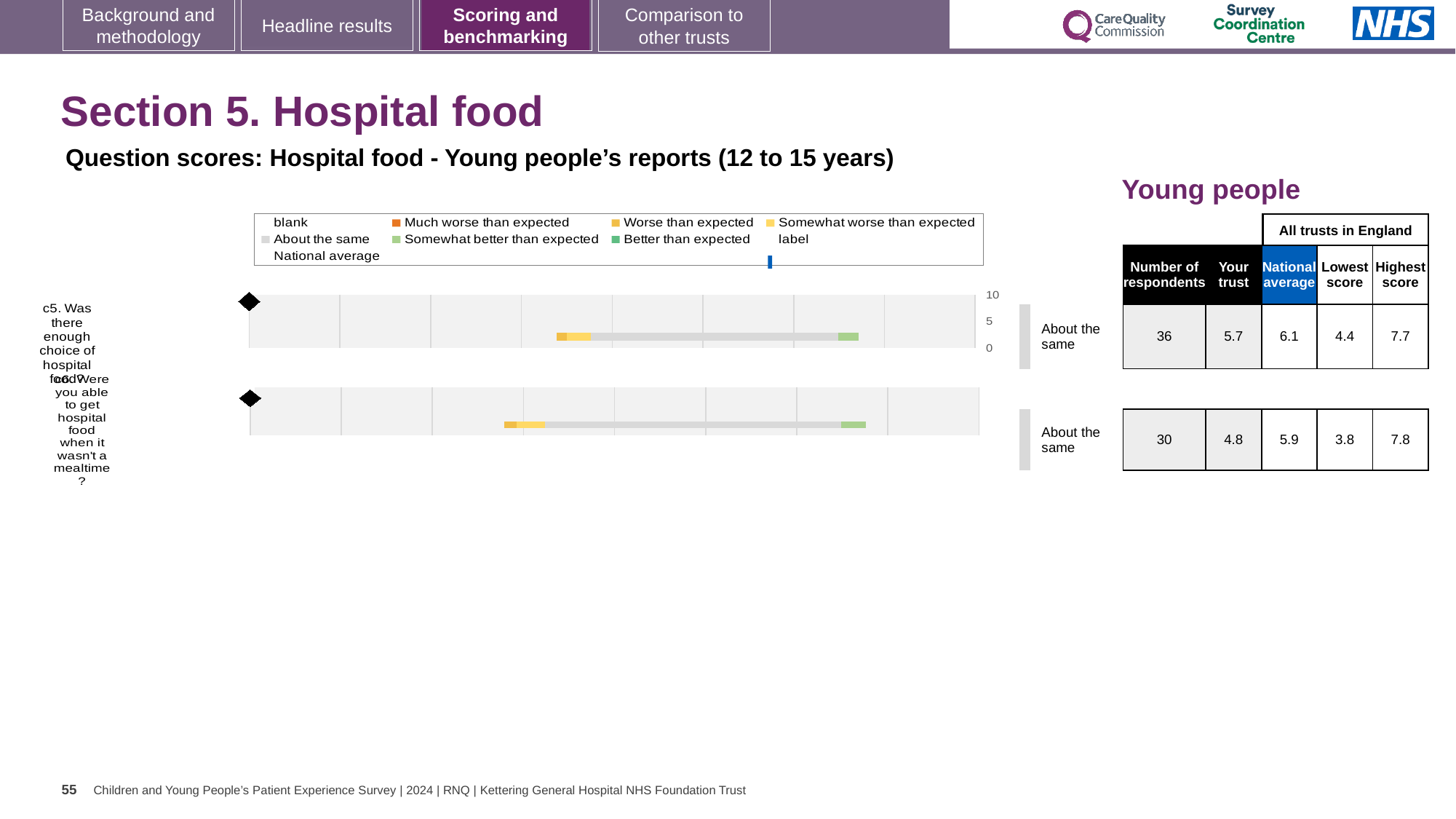
What benchmark category is shown next to the c6 chart? About the same In the table beside the charts, what is the national average for c5? 6.1 In the table beside the charts, what is the 'Your trust' score for c6 (able to get hospital food when it wasn't a mealtime)? 4.8 In the table beside the charts, what is the 'Your trust' score for c5 (enough choice of hospital food)? 5.7 In the table beside the charts, which question has the higher 'Your trust' score, c5 or c6? c5 How many questions (categories) are plotted in the hospital food charts? 2 What is the highest value shown on the vertical axis of the c5 chart? 10 What benchmark category is shown next to the c5 chart? About the same What kind of chart is used to show the question scores for c5 and c6? bar chart In the table beside the charts, how many respondents answered c5? 36 Which legend entry is shown in orange in the chart legend? Much worse than expected In the table beside the charts, what is the difference between the national average and the trust score for c6? 1.1